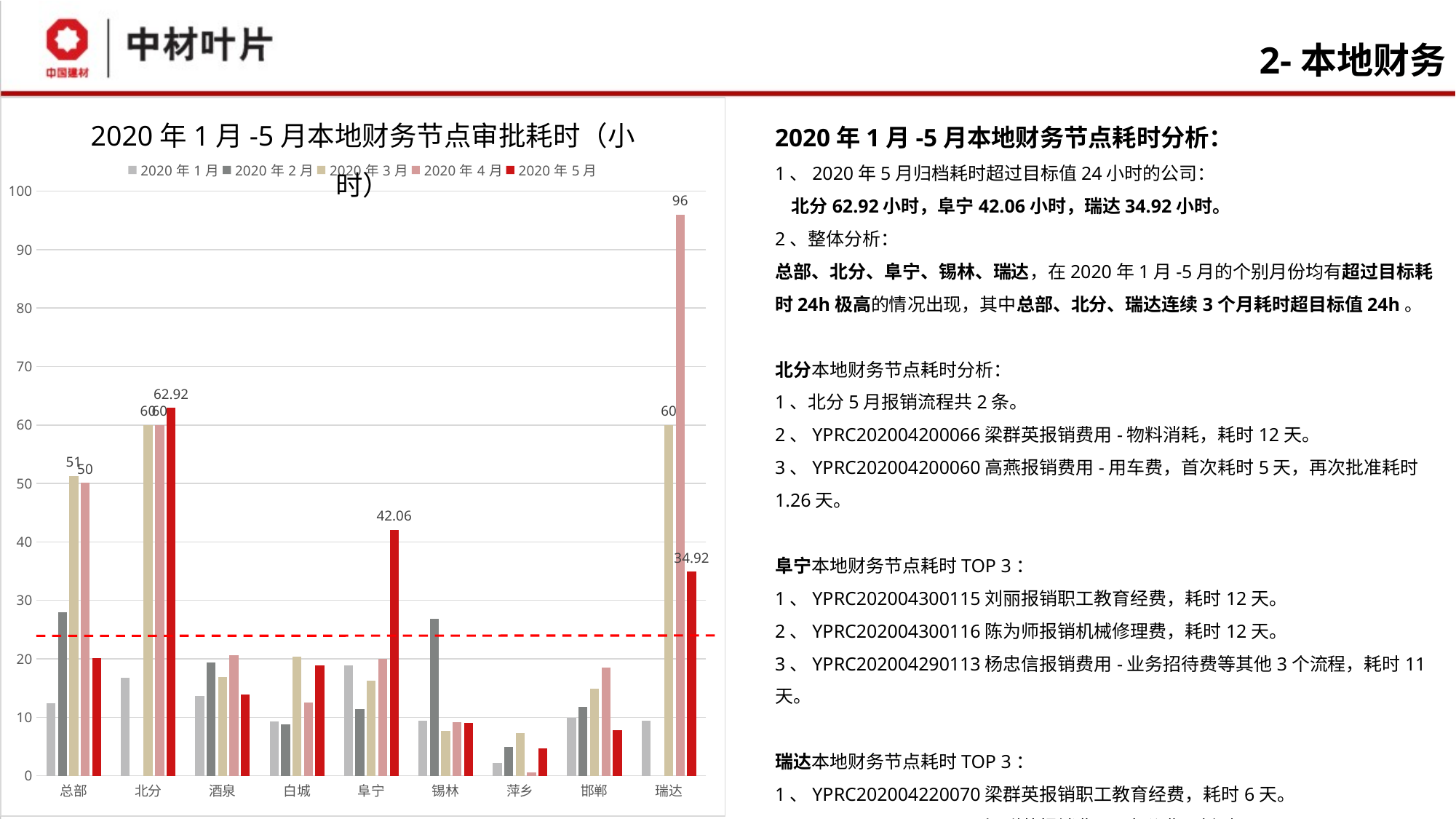
What is the title of the chart? 2020年1月-5月本地财务节点审批耗时（小时） What is the difference between the 2020年5月 values for 北分 and 瑞达? 28 What is the difference between the 2020年4月 and 2020年3月 values for 瑞达? 36 Is the value for 锡林 in the 2020年2月 series greater or less than 20? greater What is the value for 北分 in the 2020年5月 series? 62.92 Which category has the highest value in the 2020年5月 series? 北分 What is the value for 瑞达 in the 2020年5月 series? 34.92 What is the value for 瑞达 in the 2020年4月 series? 96 What kind of chart is shown on the slide? bar chart How many series does the legend list? 5 What is the value for 阜宁 in the 2020年5月 series? 42.06 How many categories are shown on the x axis? 9